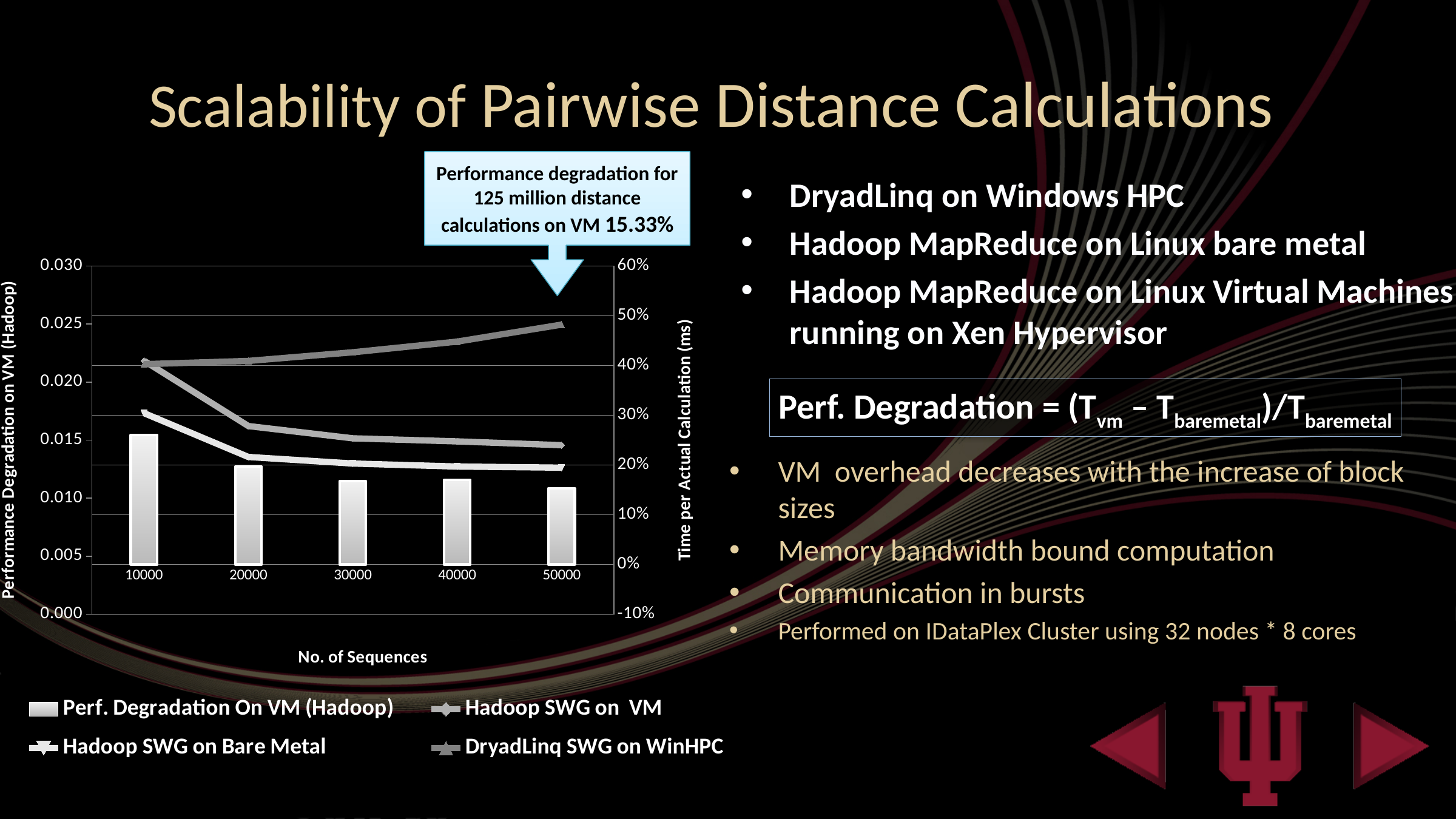
At which number of sequences is the Perf. Degradation On VM (Hadoop) bar highest? 10000 At 50000 sequences, which is higher: DryadLinq SWG on WinHPC or Hadoop SWG on VM? DryadLinq SWG on WinHPC What kind of chart is shown on the slide? A combined bar and line chart How many series does the chart legend list? 4 Does the Hadoop SWG on VM line rise or fall as the number of sequences increases? Falls At 10000 sequences, which is higher: Hadoop SWG on VM or Hadoop SWG on Bare Metal? Hadoop SWG on VM What is the title of the chart's x axis? No. of Sequences How many No. of Sequences categories are shown on the x axis? 5 Does the DryadLinq SWG on WinHPC line rise or fall as the number of sequences increases? Rises